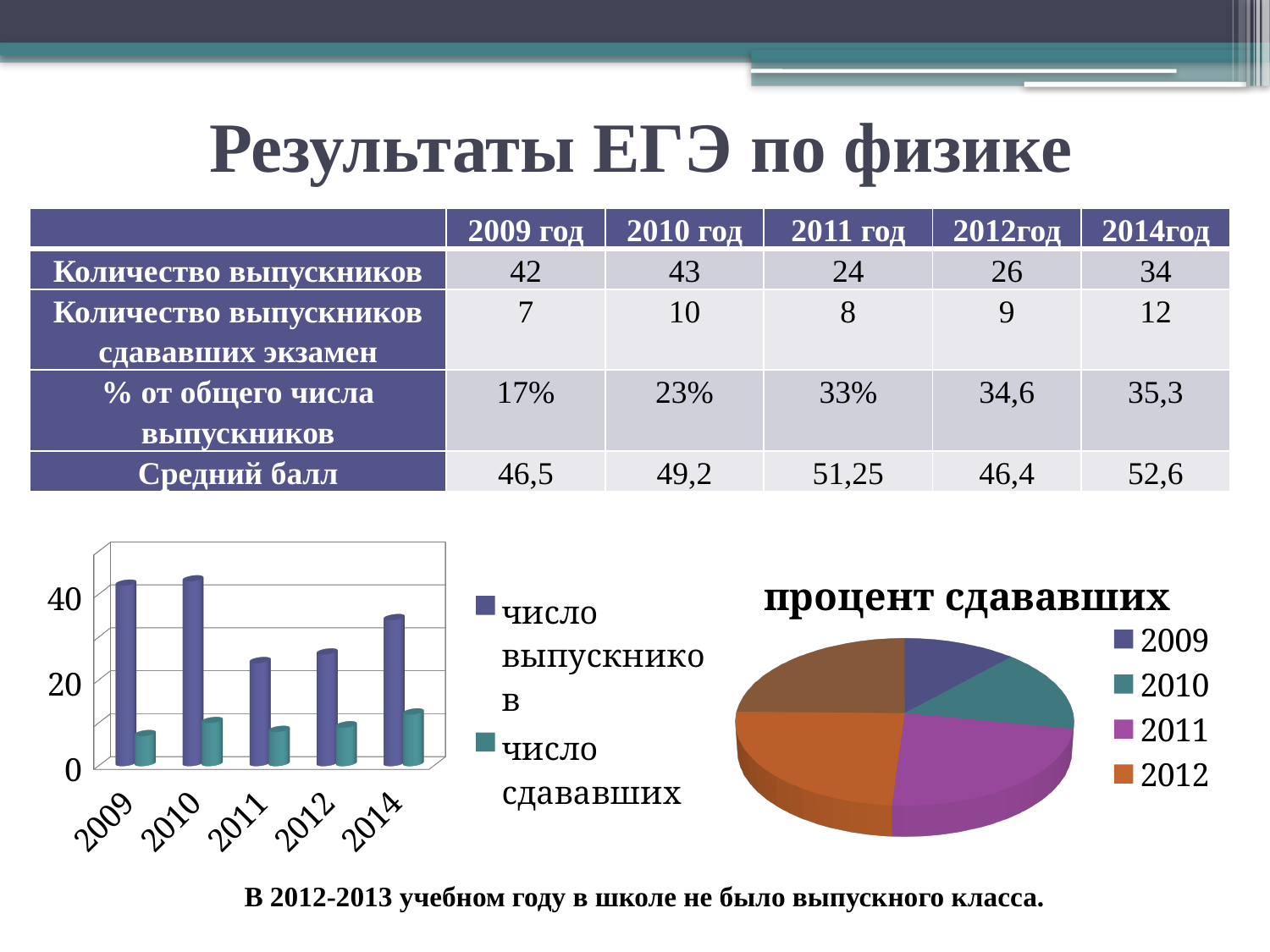
How many series does the legend of the bar chart on the left list? 2 What kind of chart is the chart on the left of the slide? bar chart In the bar chart on the left, which series has the taller bar for 2009, "число выпускников" or "число сдававших"? число выпускников In the pie chart "процент сдававших", which year has the smallest slice? 2009 What kind of chart is the chart titled "процент сдававших"? pie chart How many year categories are shown on the x axis of the bar chart on the left? 5 In the bar chart on the left, is the value of "число сдававших" for 2014 greater or less than 20? less In the bar chart on the left, is the value of "число выпускников" for 2014 greater or less than 20? greater In the bar chart on the left, is the value of "число выпускников" for 2011 greater or less than 20? greater How many slices does the pie chart "процент сдававших" have? 5 What is the title of the pie chart on the right of the slide? процент сдававших